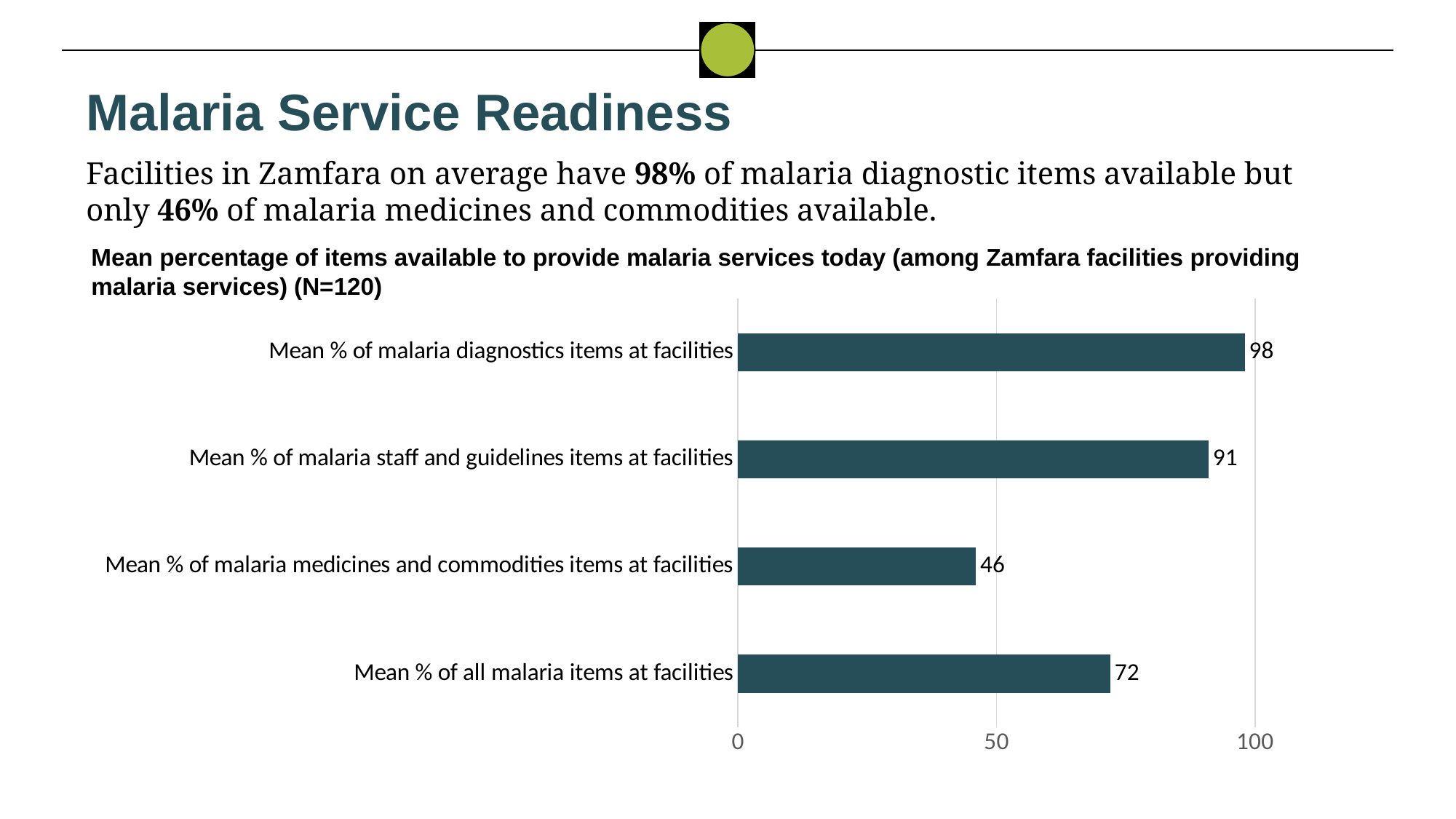
How many categories are shown in the chart? 4 What is the mean % of malaria staff and guidelines items at facilities? 91 Which is larger: the mean % of malaria staff and guidelines items or the mean % of all malaria items? Mean % of malaria staff and guidelines items at facilities Which category has the lowest value? Mean % of malaria medicines and commodities items at facilities What is the mean % of malaria medicines and commodities items at facilities? 46 What is the sample size (N) stated in the chart title? N=120 What kind of chart is shown on the slide? Bar chart Which category has the highest value? Mean % of malaria diagnostics items at facilities What is the difference between the mean % of malaria diagnostics items and the mean % of malaria medicines and commodities items? 52 Is the value for mean % of malaria medicines and commodities items at facilities greater or less than 50? less What is the mean % of malaria diagnostics items at facilities? 98 What is the mean % of all malaria items at facilities? 72